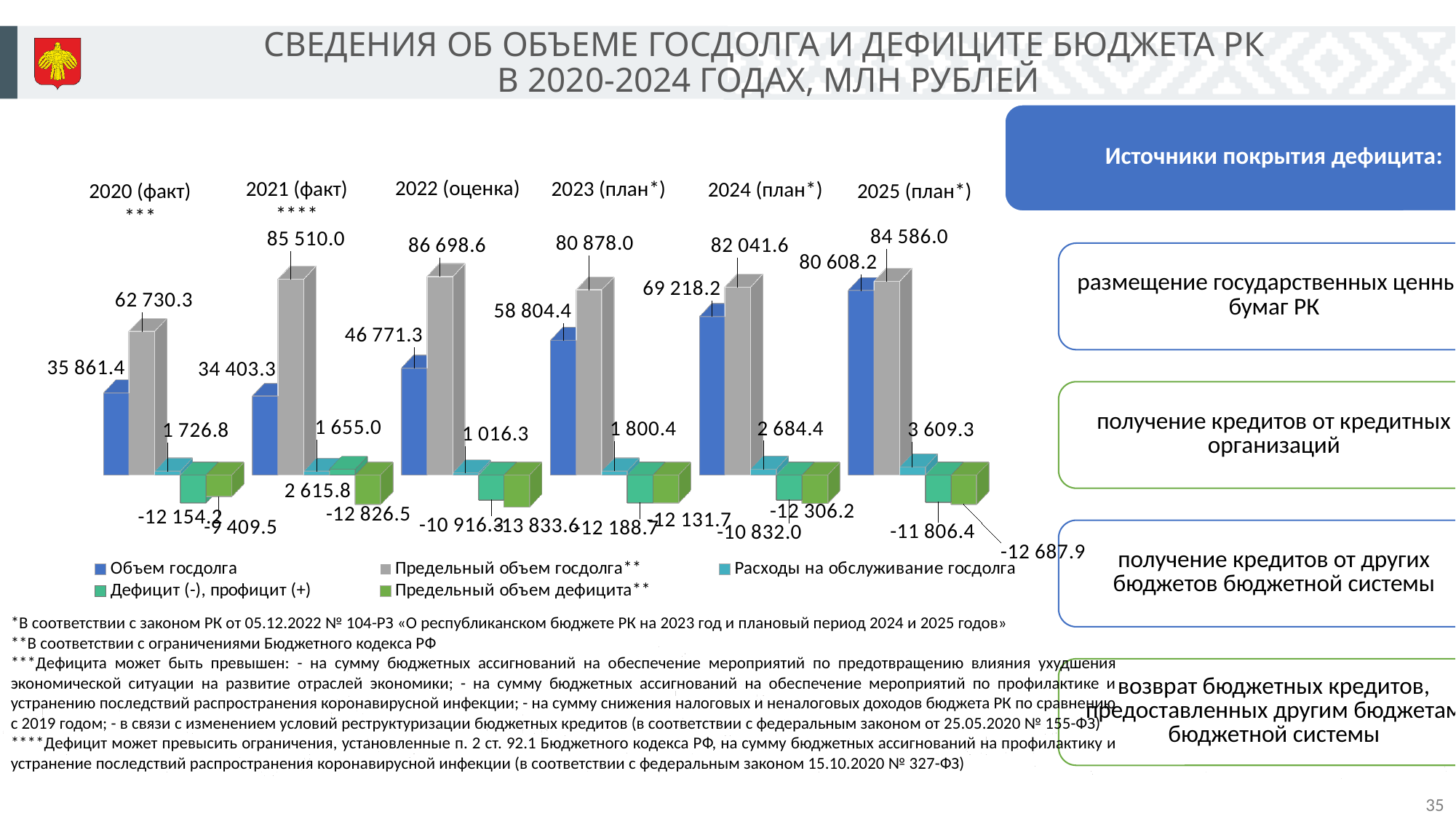
Does Объем госдолга rise or fall from 2021 (факт) to 2025 (план*)? Rises In which year is Объем госдолга the lowest? 2021 (факт) Which is larger in 2021 (факт): Предельный объем госдолга or Объем госдолга? Предельный объем госдолга What is the value of Предельный объем госдолга for 2022 (оценка)? 86 698.6 What is the value of Объем госдолга for 2020 (факт)? 35 861.4 What is the value of Расходы на обслуживание госдолга for 2024 (план*)? 2 684.4 How many series does the legend list? 5 What kind of chart is shown on the slide? Bar chart What is the difference between Предельный объем госдолга and Объем госдолга in 2025 (план*)? 3 977.8 How many year categories are shown on the chart? 6 In which year is Объем госдолга the highest? 2025 (план*) In which year is Расходы на обслуживание госдолга the lowest? 2022 (оценка)